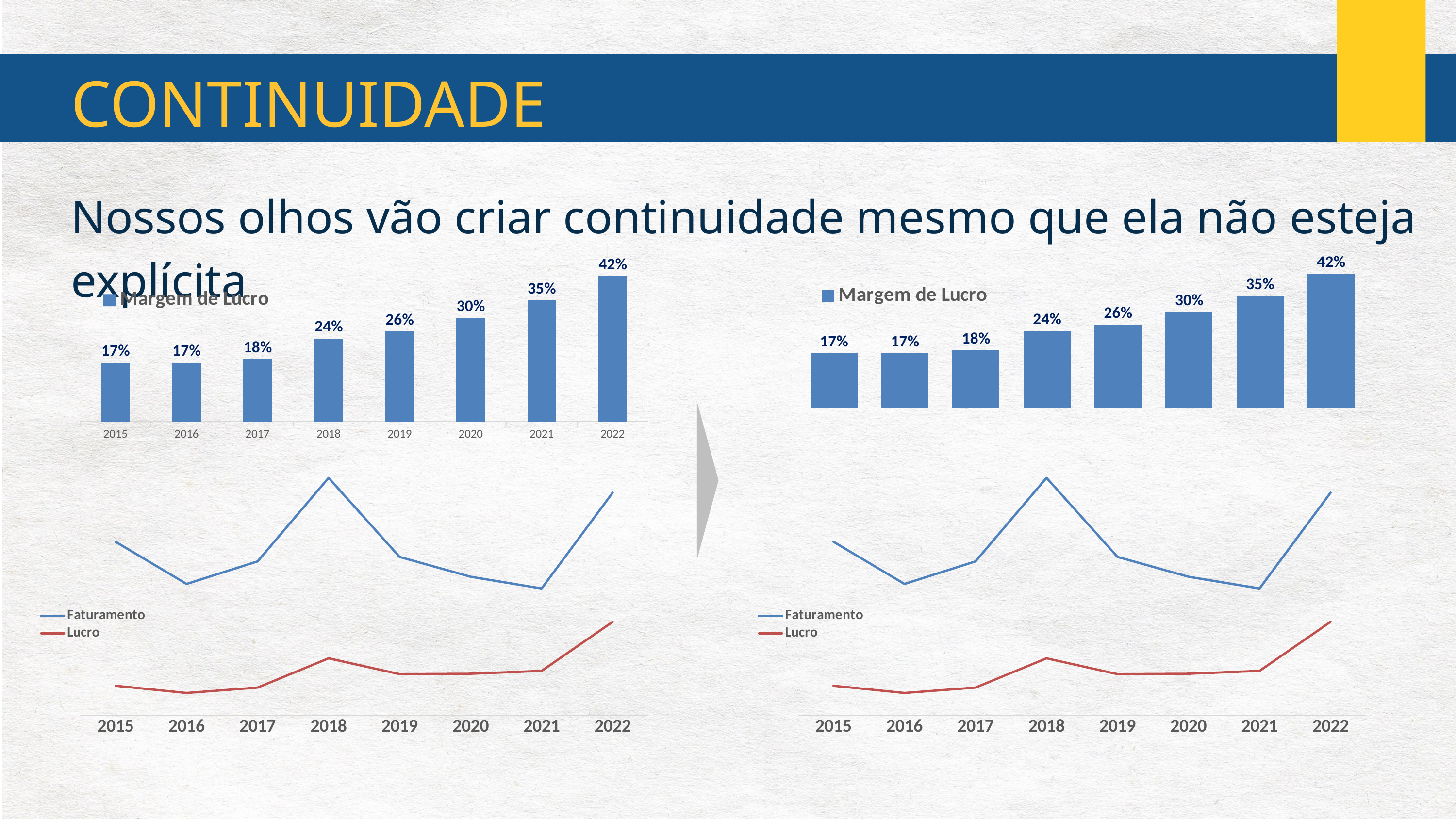
What kind of chart is the bottom-right chart with the Faturamento and Lucro series? line chart In the bottom-left line chart, in which year does the Faturamento line reach its highest point? 2018 In the top-left bar chart, do the Margem de Lucro values rise or fall from 2017 to 2022? rise What kind of chart is the top-left chart titled Margem de Lucro? bar chart In the top-left bar chart, which is larger, the Margem de Lucro for 2019 or for 2020? 2020 In the top-left bar chart, which year has the highest Margem de Lucro? 2022 In the top-right bar chart, what is the Margem de Lucro value for 2021? 35% In the bottom-right line chart, which series is drawn in red? Lucro In the top-left bar chart, what is the Margem de Lucro value for 2018? 24% How many series does the legend of the bottom-left line chart list? 2 In the top-right bar chart, what is the difference between the Margem de Lucro values for 2022 and 2015? 25%